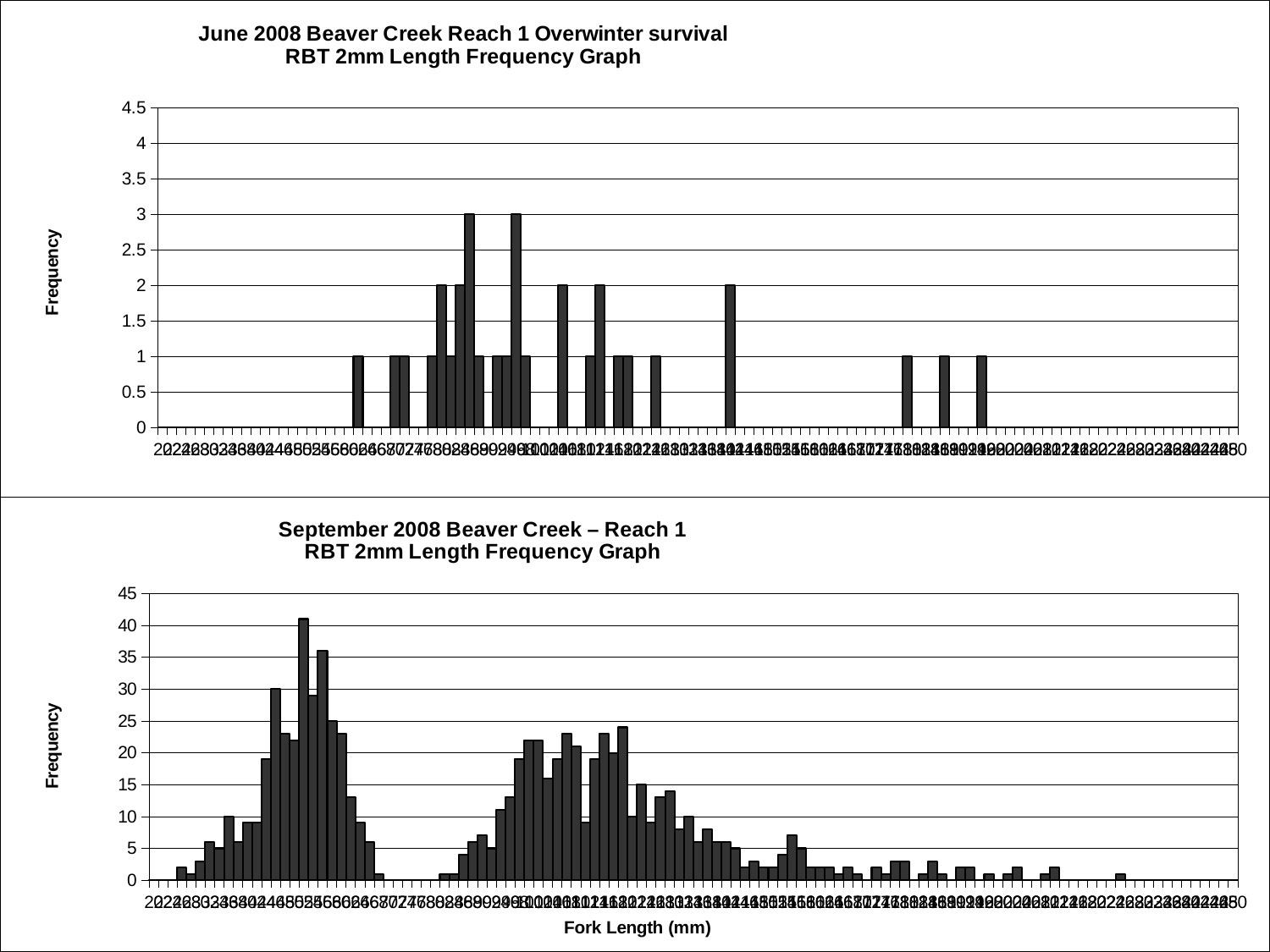
In the bottom chart, is the tallest bar greater or less than 45? less In the top chart, what is the highest frequency value reached by any bar? 3 What kind of chart is the bottom chart, 'September 2008 Beaver Creek – Reach 1'? bar chart In the bottom chart, do the bar heights generally rise or fall moving from the middle cluster toward the right end of the x axis? fall What is the x-axis label of the bottom chart? Fork Length (mm) What is the title of the top chart? June 2008 Beaver Creek Reach 1 Overwinter survival RBT 2mm Length Frequency Graph What kind of chart is the top chart, 'June 2008 Beaver Creek Reach 1 Overwinter survival'? bar chart In the top chart, how many bars reach a frequency of 3? 2 Which chart has the larger maximum value on its y-axis, the top (June 2008) chart or the bottom (September 2008) chart? the bottom (September 2008) chart In the top chart, is the tallest bar greater or less than 3.5? less